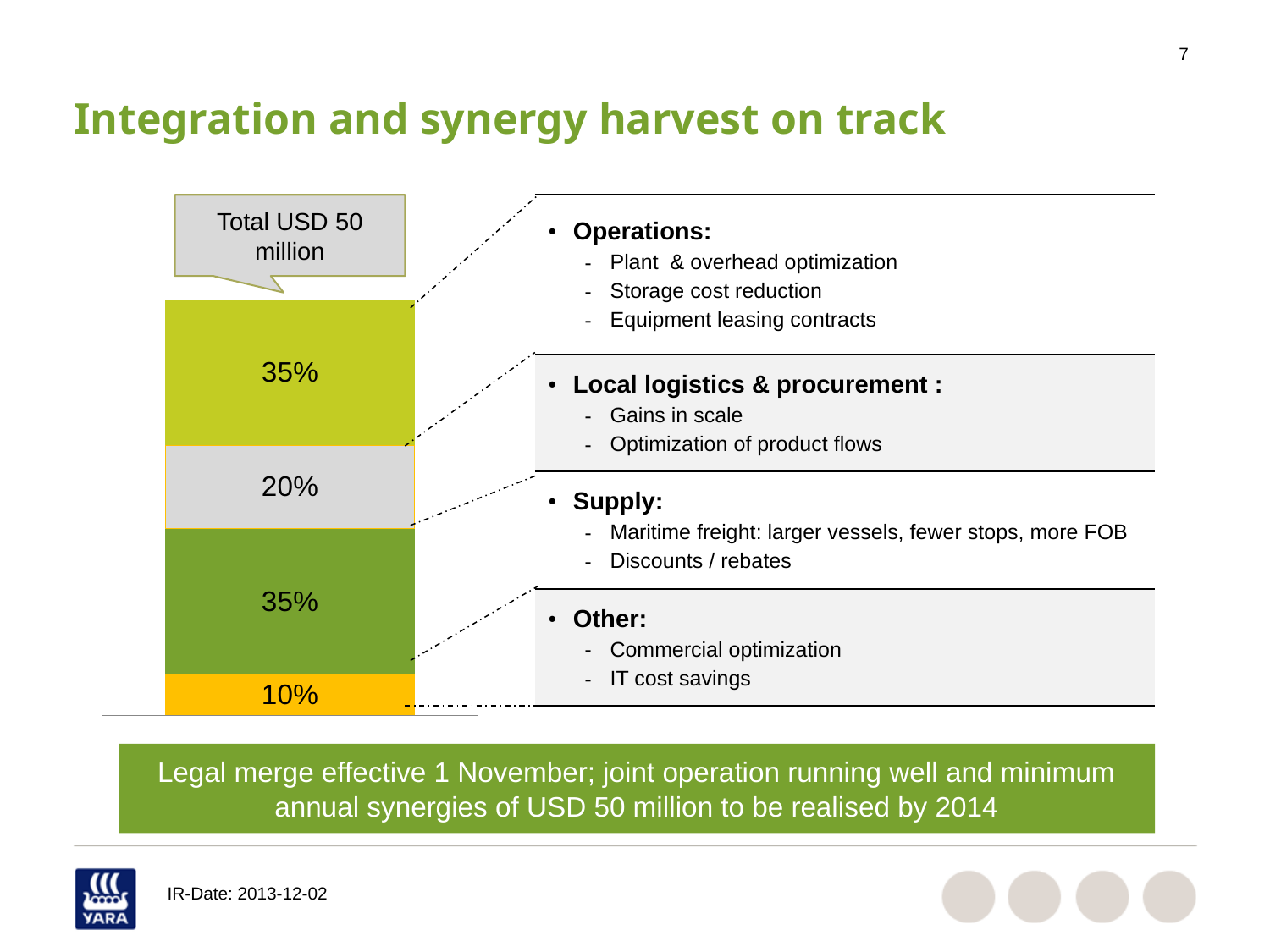
What share of the total synergies is attributed to Local logistics & procurement? 20% What colour is the segment representing Other? Yellow How many segments does the stacked bar contain? 4 What share of the total synergies is attributed to Operations? 35% What share of the total synergies is attributed to Other? 10% Which category has the smallest share of the synergies? Other What is the difference in percentage points between the Local logistics & procurement share and the Other share? 10 What total amount does the stacked bar represent, according to the callout above it? Total USD 50 million What is the combined share of Operations and Supply? 70% Which is larger, the share for Supply or the share for Local logistics & procurement? Supply What kind of chart is shown on the slide? Stacked bar chart What share of the total synergies is attributed to Supply? 35%